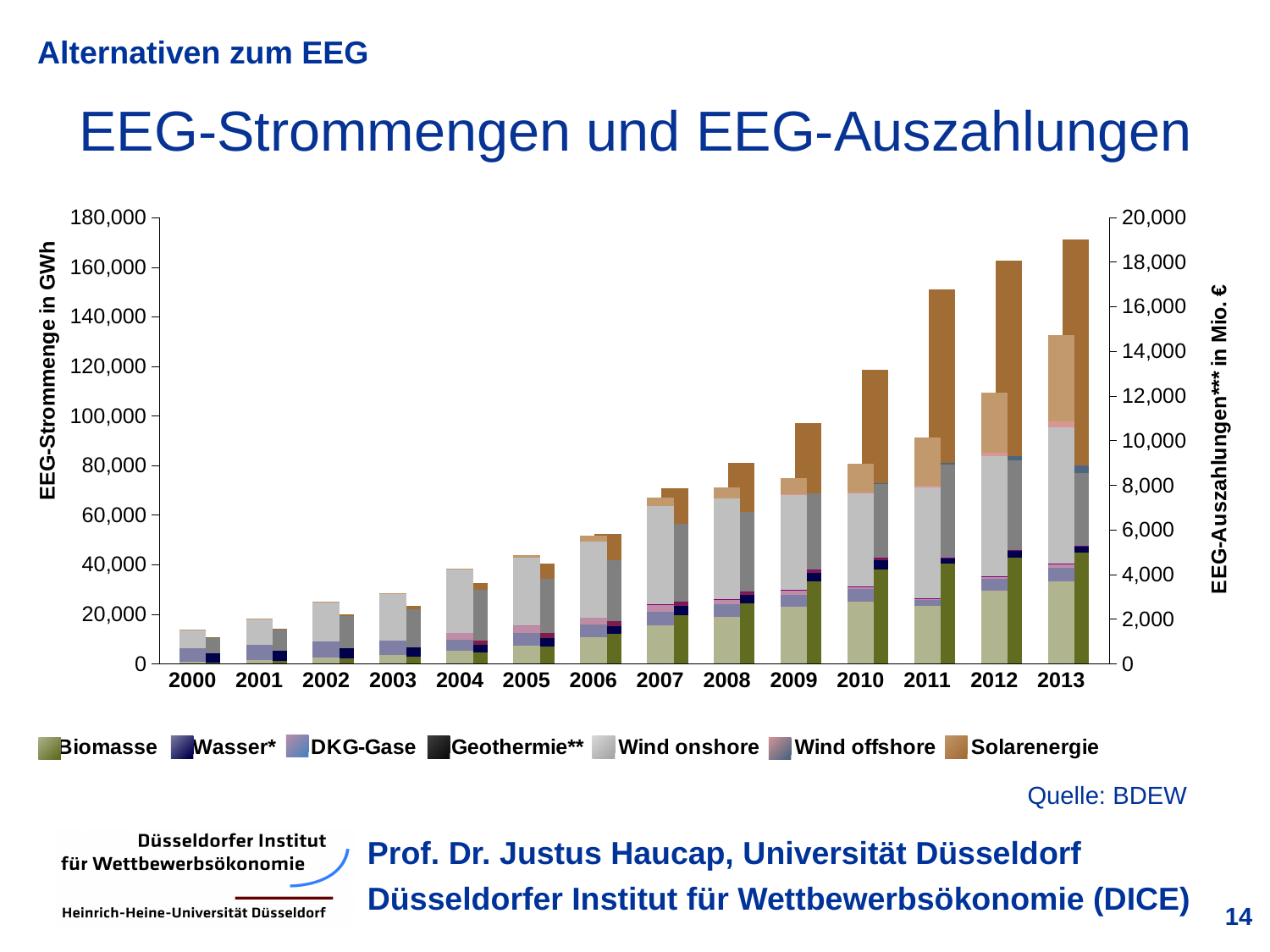
How many years are shown on the x axis of the chart? 14 Which year has the shortest bars in the chart? 2000 What is the title of the chart on the slide? EEG-Strommengen und EEG-Auszahlungen Is the taller bar for 2010, read against the right axis, greater or less than 12,000? greater How many series does the chart legend list? 7 What kind of chart is shown on the slide? stacked bar chart Do the bar heights generally rise or fall from 2000 to 2013? rise What is the label of the left vertical axis? EEG-Strommenge in GWh Which year has the tallest bars in the chart? 2013 Is the shorter bar for 2000, read against the left axis, greater or less than 20,000? less Which year has taller bars, 2005 or 2009? 2009 Is the taller bar for 2013, read against the right axis, greater or less than 18,000? greater